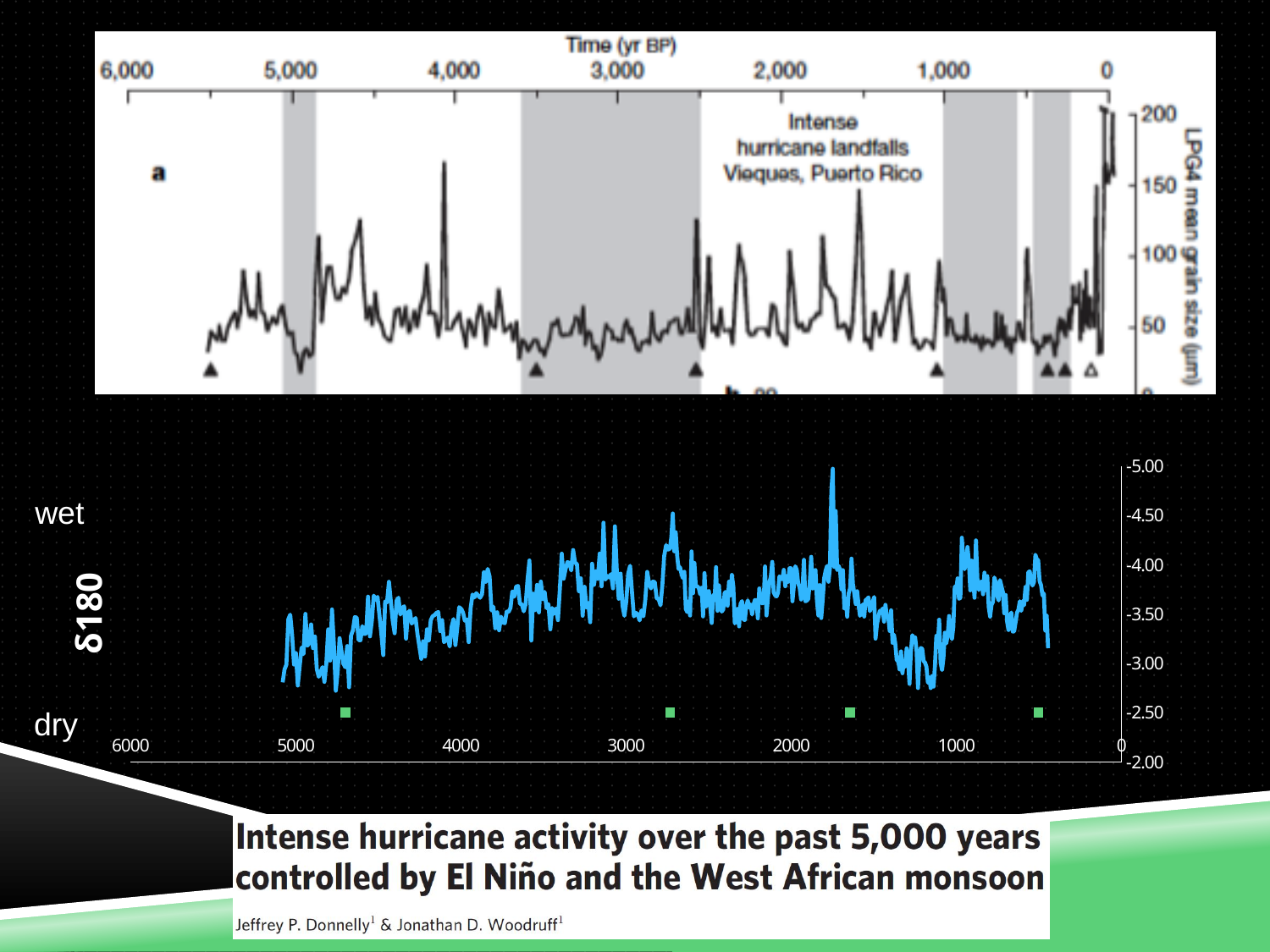
In the bottom chart, which is closer to the 'wet' end: the blue line's peak near 1750 or its trough near 1200? the peak near 1750 In the bottom chart, around 1200 on the x axis, is the blue line closer to the 'dry' end or the 'wet' end of the y axis? dry In the top chart, is the value of the black line at about 3,000 yr BP greater or less than 100 on the grain size axis? less In the top chart, how many grey shaded vertical bands are there? 4 In the top chart, is the tallest spike (near 4,100 yr BP) greater or less than 150 on the grain size axis? greater What is the x-axis label of the top chart? Time (yr BP) What kind of chart is the bottom chart with the blue line? line chart In the bottom chart, does the highest peak of the blue line (around 1750 on the x axis) reach above the -4.50 tick toward the 'wet' end? yes What is the title printed inside the top chart? Intense hurricane landfalls Vieques, Puerto Rico In the top chart, how many filled black triangle markers are shown along the bottom of the plot? 6 In the bottom chart, how many green square markers are plotted below the blue line? 4